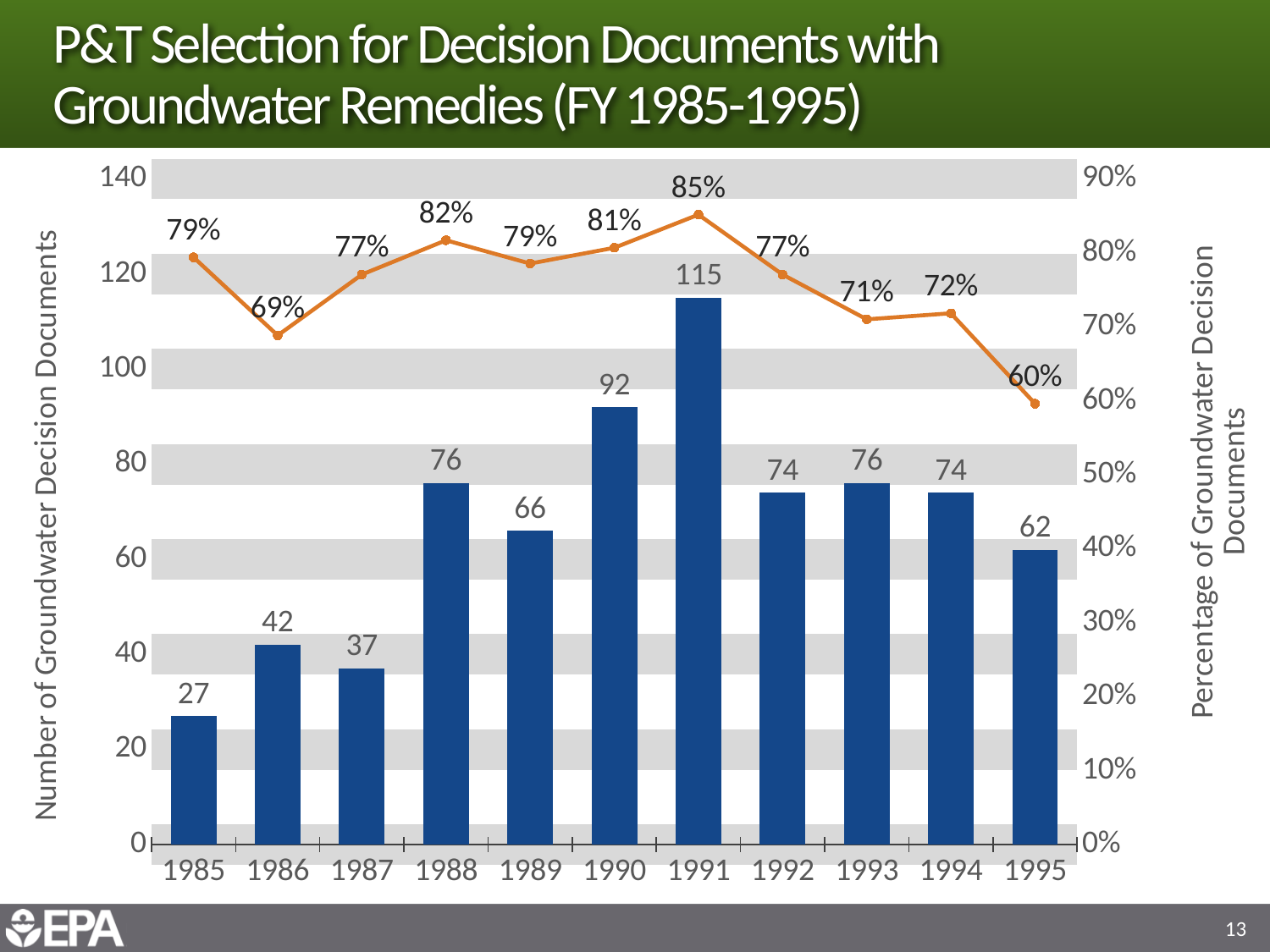
What is the label of the right-hand vertical axis? Percentage of Groundwater Decision Documents What percentage of groundwater decision documents is shown for 1988? 82% What kind of chart is used to show the number of groundwater decision documents? bar chart Which year has the lowest percentage of groundwater decision documents? 1995 Which year has the highest number of groundwater decision documents? 1991 What is the difference between the number of groundwater decision documents in 1990 and in 1989? 26 Which year has the lowest number of groundwater decision documents? 1985 Does the percentage of groundwater decision documents rise or fall from 1991 to 1995? fall Which year has more groundwater decision documents, 1986 or 1987? 1986 How many groundwater decision documents are shown for 1991? 115 How many years are shown on the x axis? 11 Is the percentage for 1986 greater or less than 70%? less